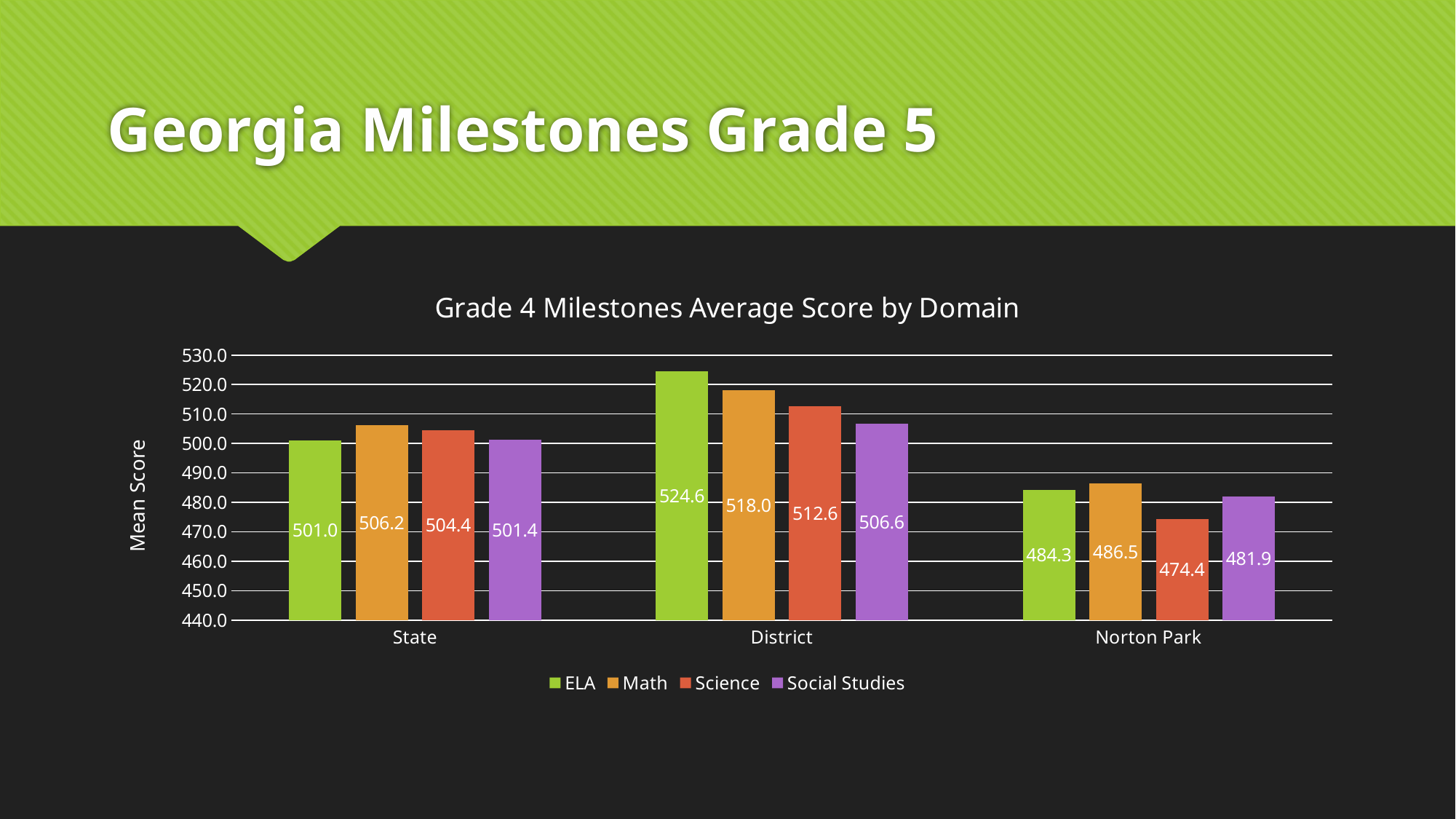
Which domain has the lowest mean score for Norton Park? Science What is the difference between the District Math score and the Norton Park Math score? 31.5 Which is larger, the State Science score or the Norton Park Science score? State Science score What is the Science mean score for Norton Park? 474.4 What is the Social Studies mean score for the State? 501.4 What is the title of the chart? Grade 4 Milestones Average Score by Domain What kind of chart is shown on the slide? Bar chart How many series does the legend list? 4 How many categories are shown on the x axis? 3 Is the Norton Park Social Studies score greater or less than 490.0? less What is the ELA mean score for the District? 524.6 Which domain has the highest mean score for the District? ELA